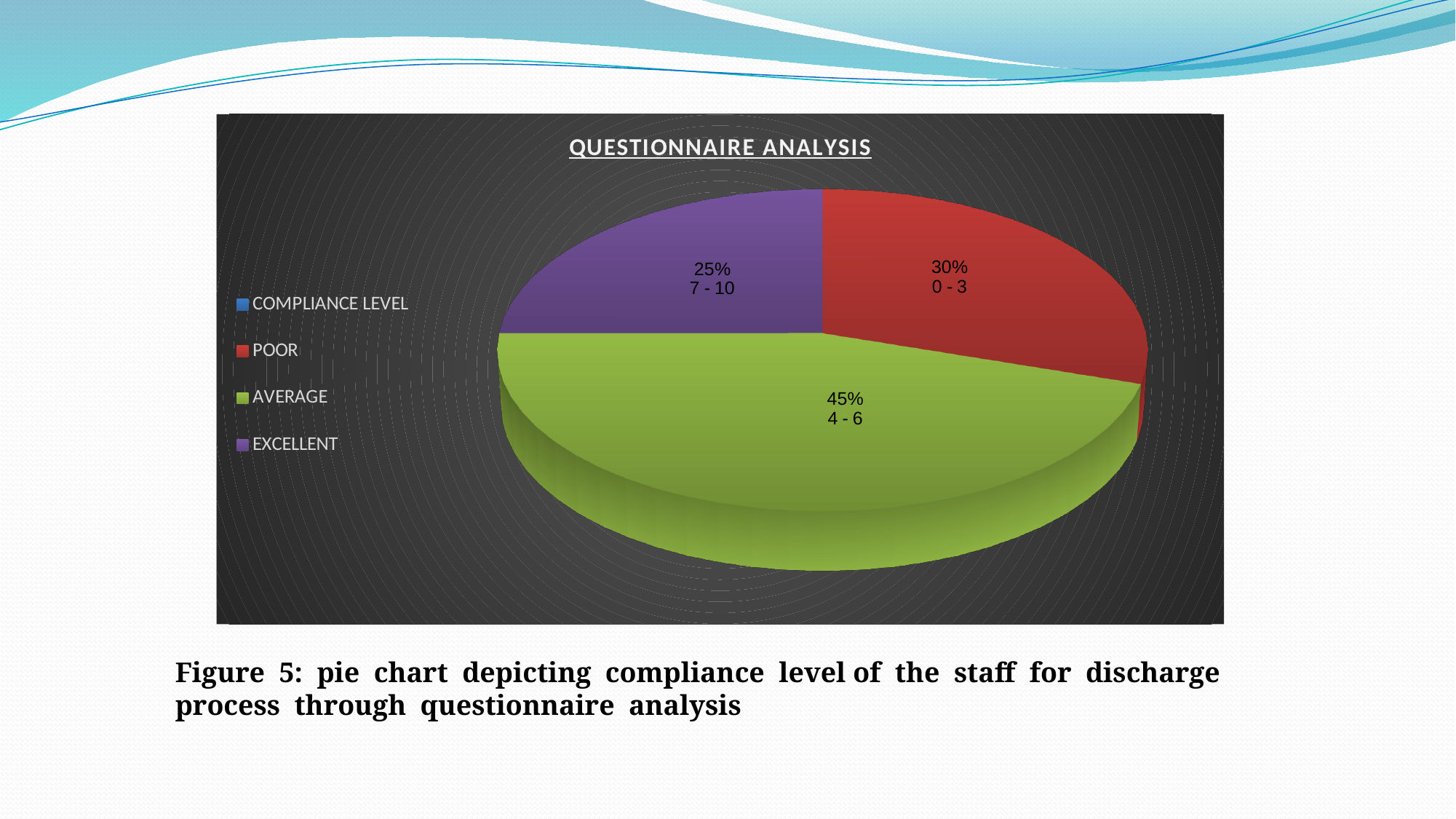
What kind of chart is shown on the slide? pie chart What score range is labelled on the EXCELLENT slice? 7 - 10 What percentage share does the AVERAGE slice have? 45% What is the title of the chart? QUESTIONNAIRE ANALYSIS Which category has the smallest slice of the pie? EXCELLENT What percentage share does the POOR slice have? 30% What score range is labelled on the AVERAGE slice? 4 - 6 What is the difference in percentage points between the AVERAGE and POOR slices? 15% How many entries does the legend list? 4 What percentage share does the EXCELLENT slice have? 25% Which category has the largest slice of the pie? AVERAGE Which slice is larger, POOR or EXCELLENT? POOR